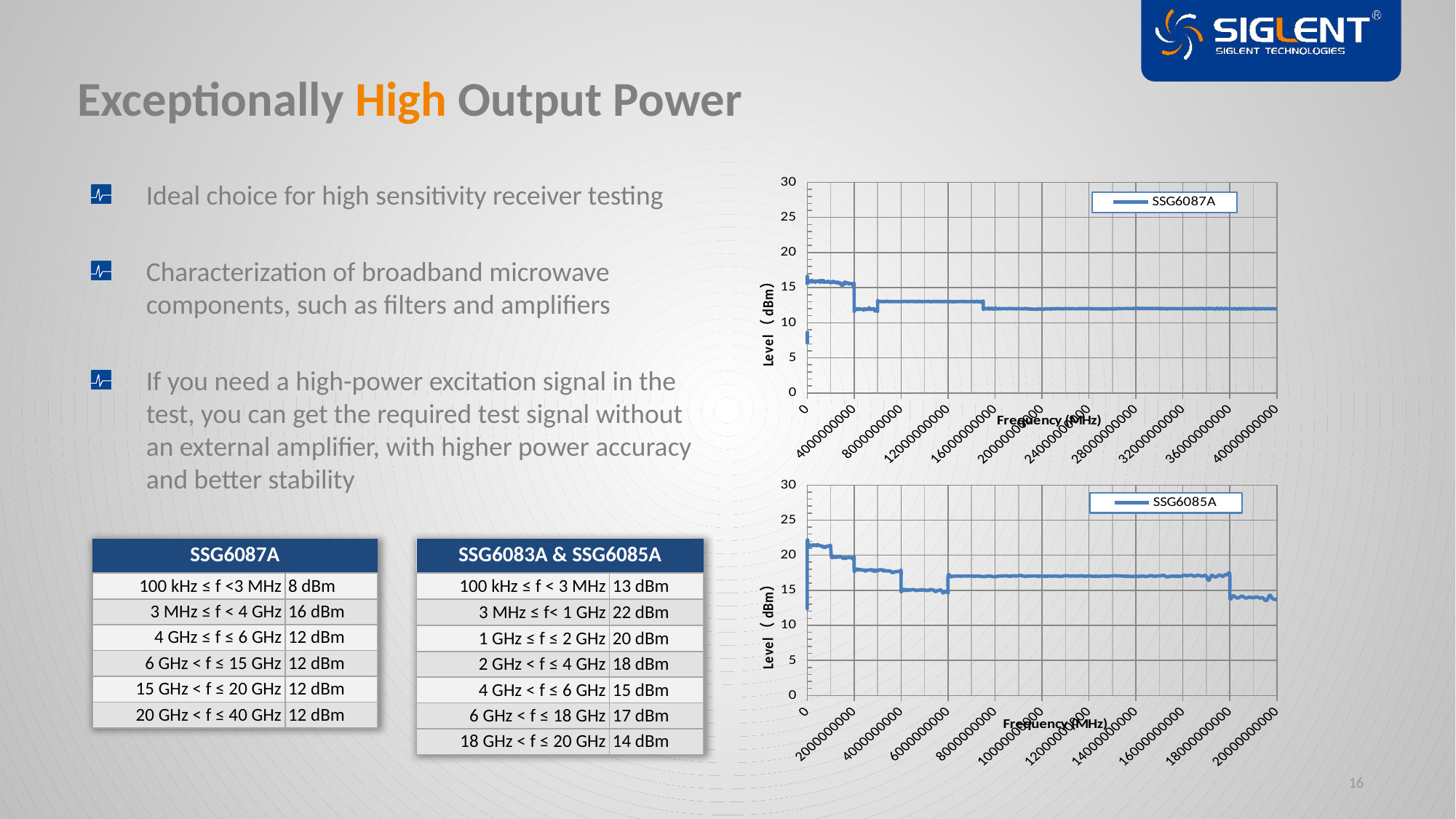
In the bottom chart (SSG6085A), is the level at 2000000000 on the x axis greater or less than 15? greater In the bottom chart (SSG6085A), which is larger: the level at 1000000000 or the level at 19000000000 on the x axis? 1000000000 In the top chart (SSG6087A), is the level at 20000000000 on the x axis greater or less than 10? greater What is the y-axis title of the bottom chart (SSG6085A)? Level (dBm) In the bottom chart (SSG6085A), is the level at 10000000000 on the x axis greater or less than 20? less What kind of chart is the top chart (SSG6087A)? line chart In the top chart (SSG6087A), does the level generally rise or fall as frequency increases along the x axis? fall What is the legend entry of the top chart? SSG6087A How many series does the legend of the bottom chart list? 1